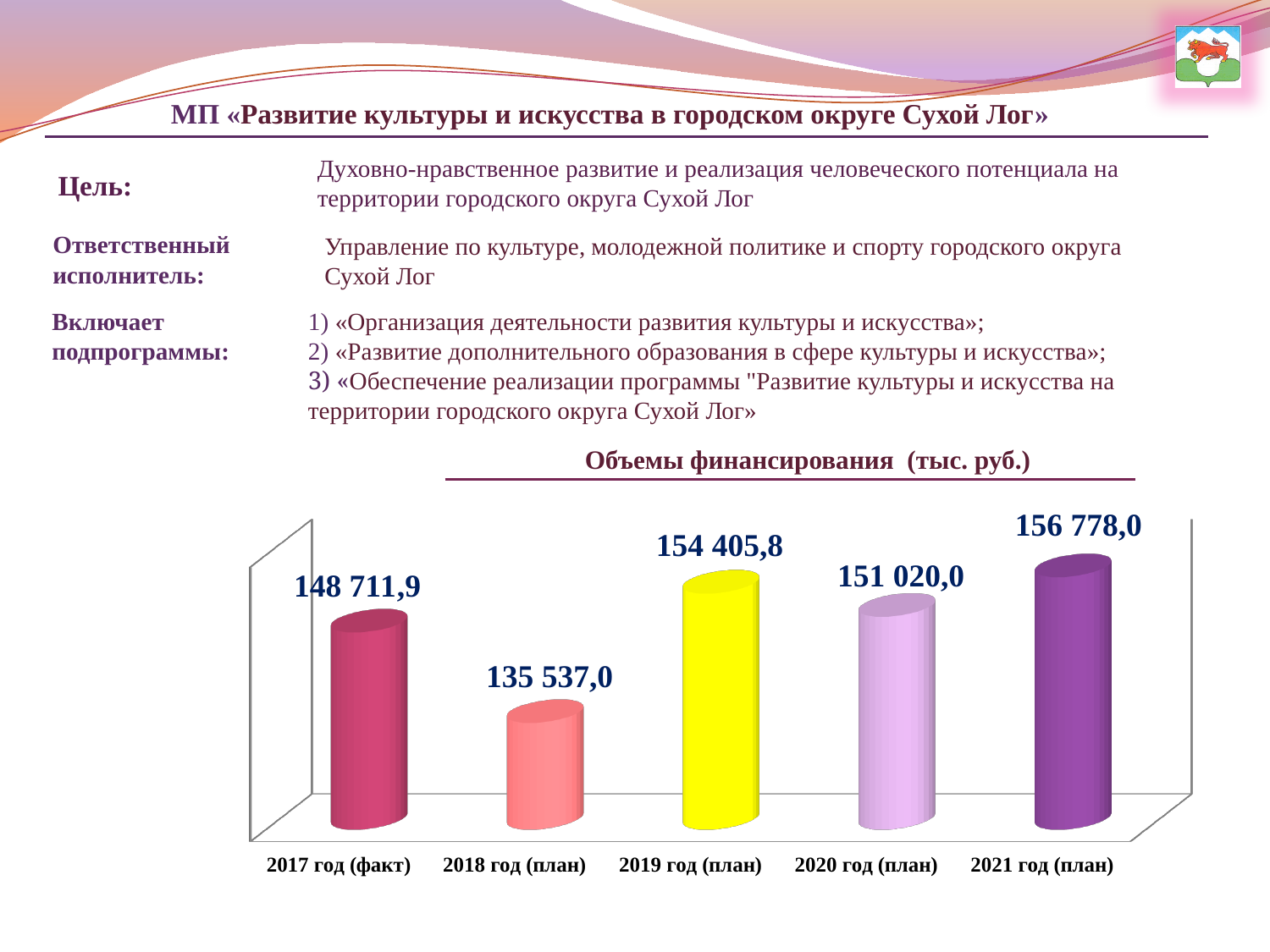
What is the difference between the values for 2021 год (план) and 2018 год (план)? 21 241,0 What is the title of the chart? Объемы финансирования (тыс. руб.) What is the value for 2018 год (план)? 135 537,0 Which year has the lowest funding volume? 2018 год (план) Which is larger, the value for 2019 год (план) or 2020 год (план)? 2019 год (план) What is the value for 2021 год (план)? 156 778,0 How many years (categories) are shown in the chart? 5 What is the value for 2019 год (план)? 154 405,8 What kind of chart is shown on the slide? Bar chart What is the value for 2017 год (факт) in the chart «Объемы финансирования (тыс. руб.)»? 148 711,9 Which year has the highest funding volume? 2021 год (план) What is the difference between the values for 2019 год (план) and 2017 год (факт)? 5 693,9